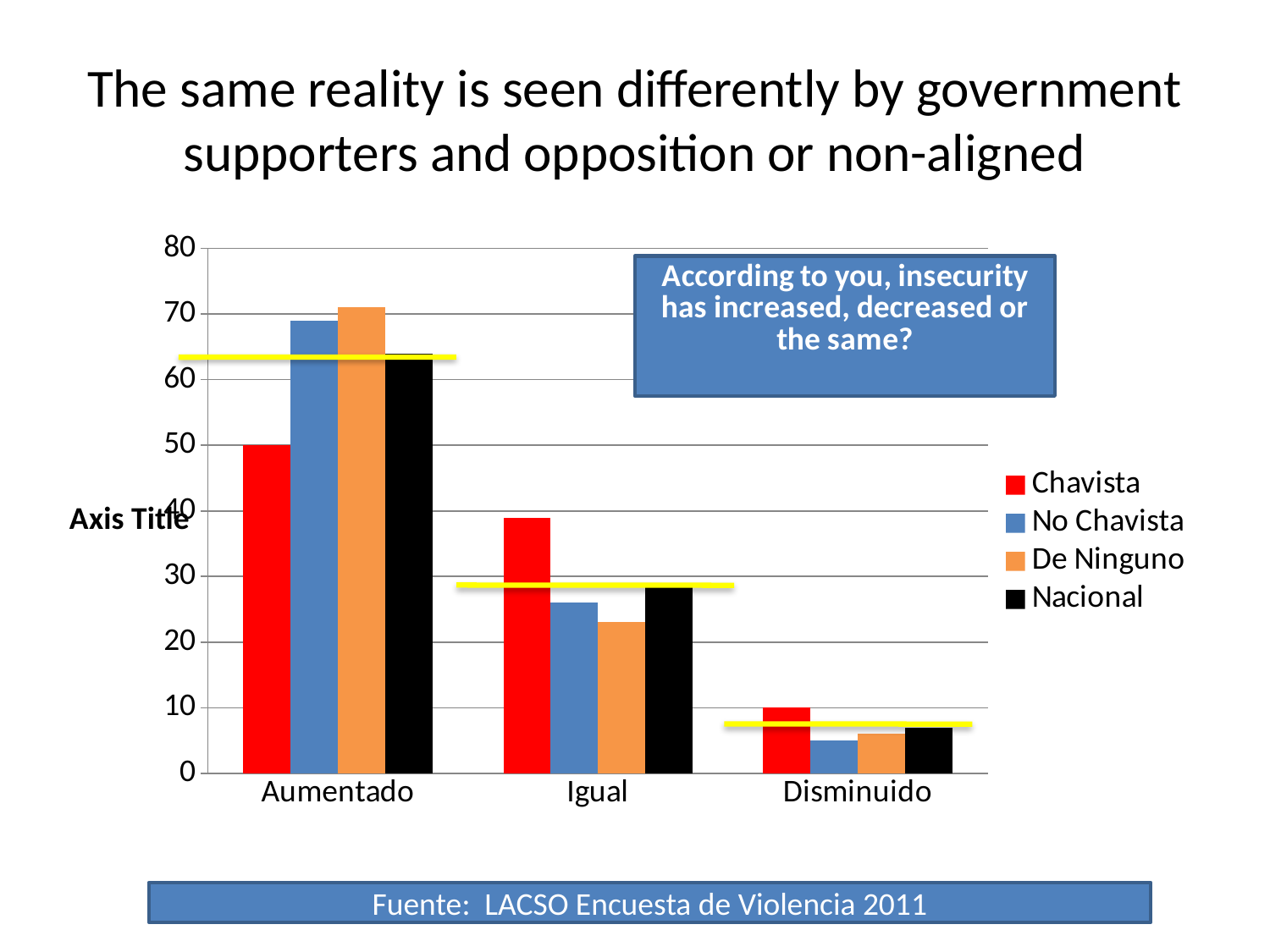
Which series has the highest value for Igual? Chavista How many categories are shown on the x axis? 3 Do the Chavista values rise or fall from Aumentado to Disminuido along the x axis? fall How many series does the legend list? 4 What are the four entries in the legend? Chavista, No Chavista, De Ninguno, Nacional Is the value for No Chavista in Aumentado greater or less than 60? greater What kind of chart is shown on the slide? bar chart Which series has the highest value for Disminuido? Chavista Is the value for De Ninguno in Igual greater or less than 30? less Which series has the lowest value for Aumentado? Chavista For Igual, which is larger: Chavista or No Chavista? Chavista Is the value for Chavista in Aumentado greater or less than 60? less